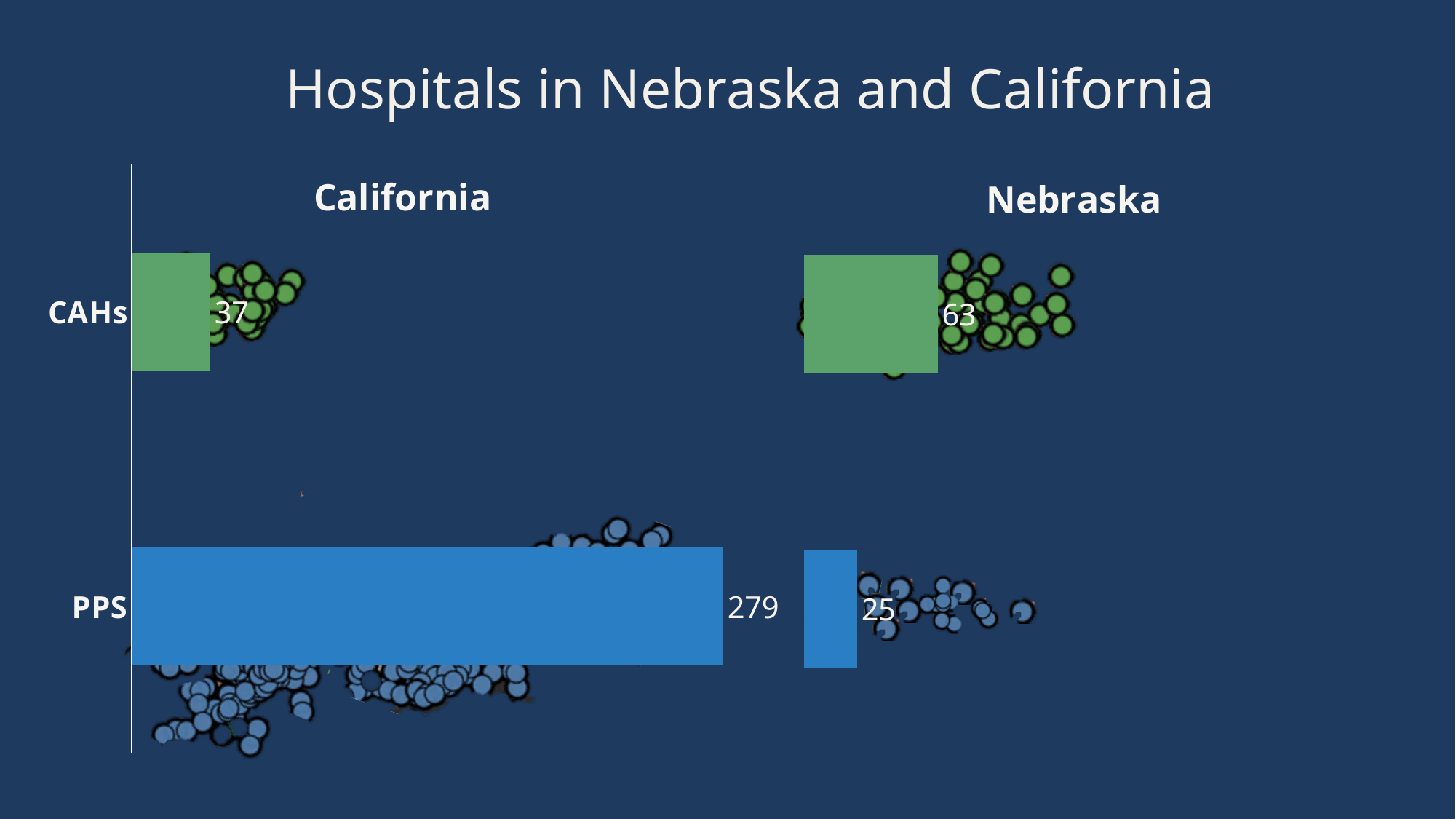
What is the difference between the number of CAHs in Nebraska and in California? 26 What is the difference between the number of PPS hospitals in California and in Nebraska? 254 Which state has more PPS hospitals, California or Nebraska? California Which state has more CAHs, California or Nebraska? Nebraska Which bar shows the largest value on the chart? California PPS How many hospital categories are shown on the chart? 2 How many CAHs are there in Nebraska? 63 How many PPS hospitals are there in Nebraska? 25 What kind of chart is shown on the slide? bar chart How many PPS hospitals are there in California? 279 How many CAHs are there in California? 37 What is the title of the chart? Hospitals in Nebraska and California